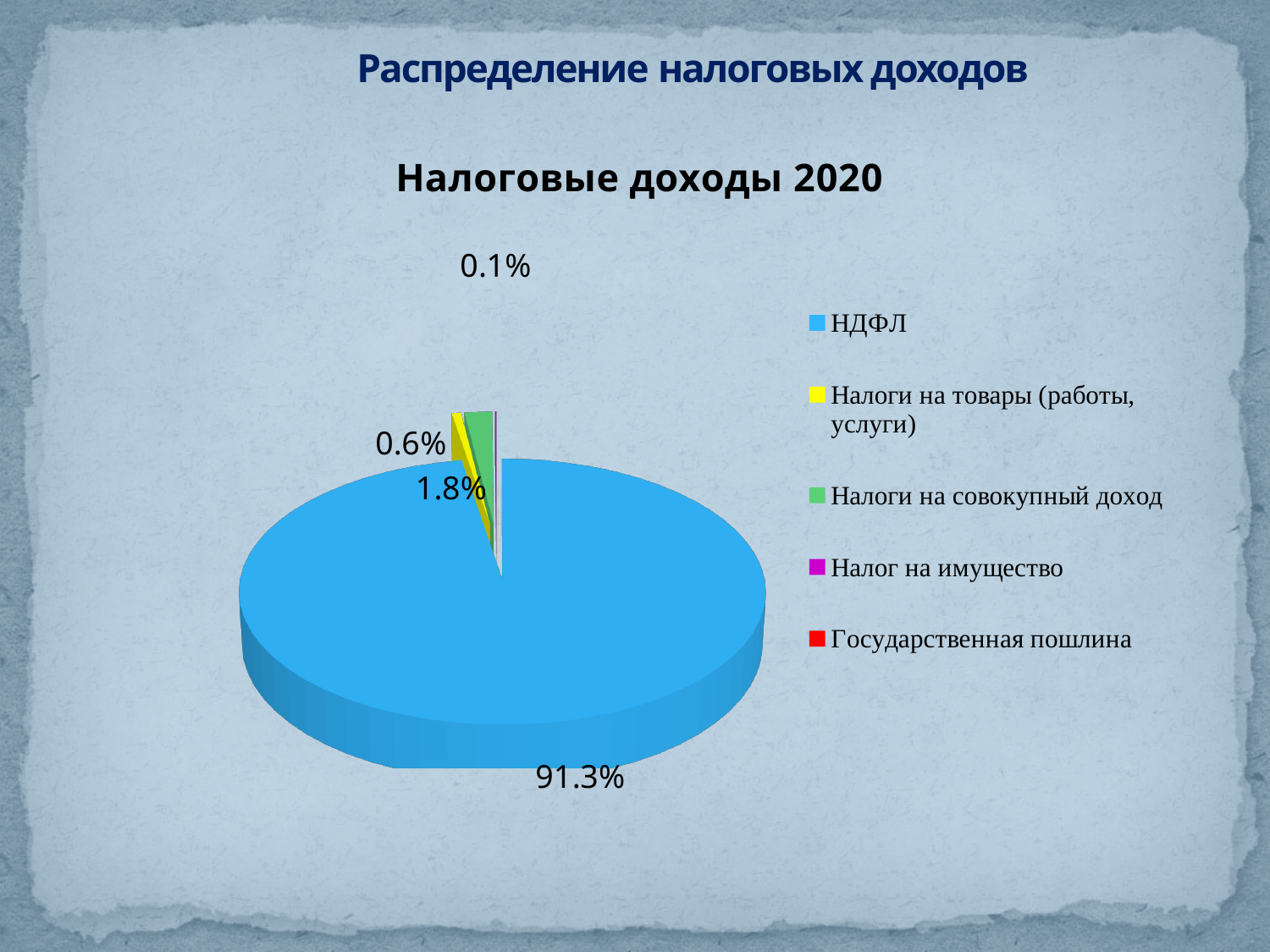
What colour is the slice for НДФЛ? blue What is the title of the chart? Налоговые доходы 2020 What is the difference between the share for Налоги на совокупный доход and the share for Налоги на товары (работы, услуги)? 1.2 percentage points What is the smallest percentage label printed on the chart? 0.1% What share of the pie does НДФЛ take? 91.3% What is the value shown for Налоги на совокупный доход? 1.8% Which category has the largest slice of the pie? НДФЛ What kind of chart is shown on the slide? pie chart How many entries does the chart legend list? 5 Which is larger: Налоги на совокупный доход or Налоги на товары (работы, услуги)? Налоги на совокупный доход What is the value shown for Налоги на товары (работы, услуги)? 0.6% What is the difference between the share for НДФЛ and the share for Налоги на совокупный доход? 89.5 percentage points